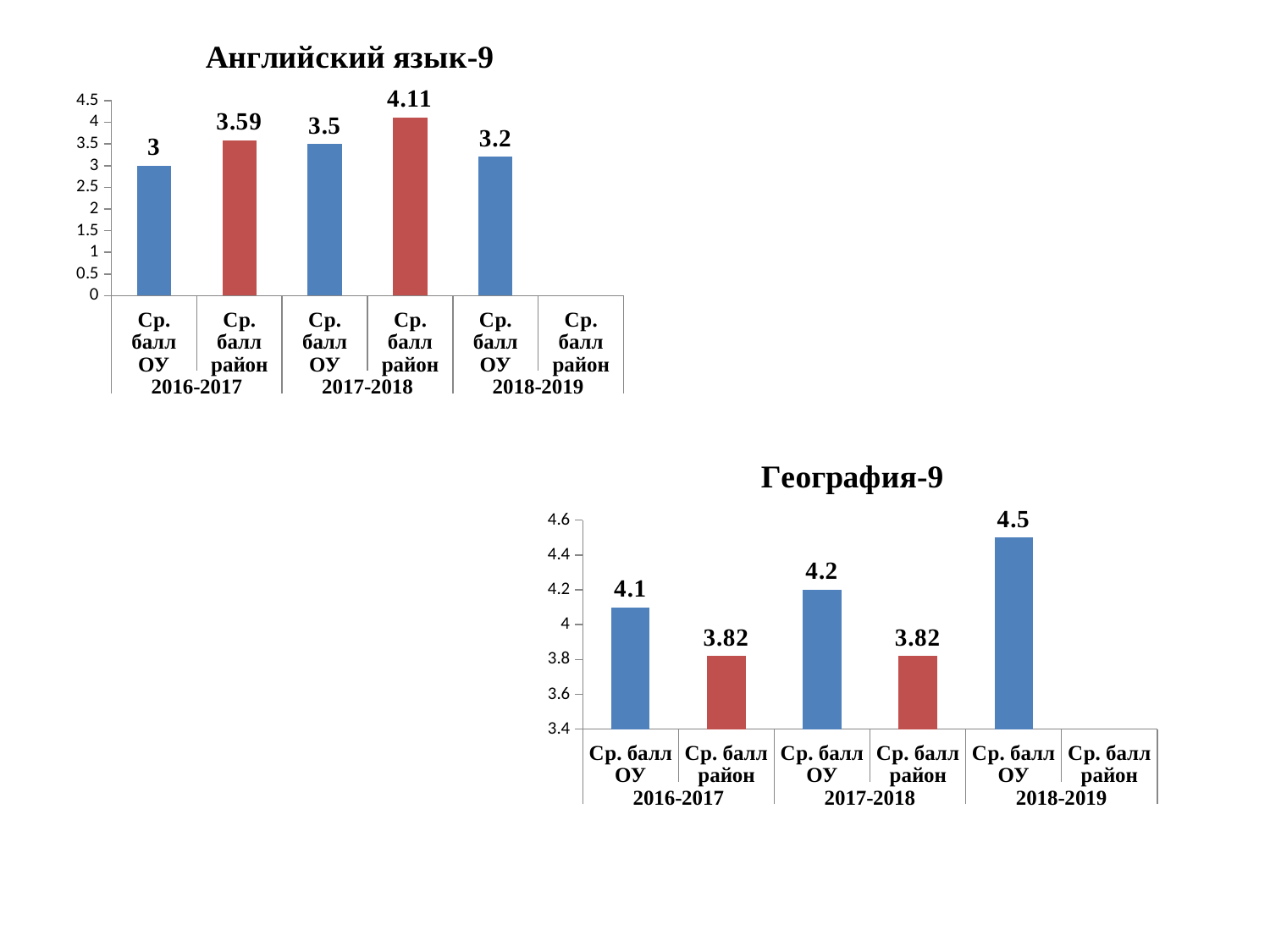
In the chart titled "Английский язык-9", which bar has the lowest value? Ср. балл ОУ, 2016-2017 In the chart titled "Английский язык-9", what is the difference between "Ср. балл район" and "Ср. балл ОУ" in 2017-2018? 0.61 In the chart titled "Английский язык-9", what is the value for "Ср. балл район" in 2017-2018? 4.11 What kind of chart is the chart titled "География-9"? bar chart In the chart titled "География-9", what is the value for "Ср. балл ОУ" in 2018-2019? 4.5 In the chart titled "Английский язык-9", what is the value for "Ср. балл ОУ" in 2016-2017? 3 In the chart titled "География-9", what is the value for "Ср. балл район" in 2016-2017? 3.82 In the chart titled "Английский язык-9", which bar has the highest value? Ср. балл район, 2017-2018 In the chart titled "География-9", which is larger in 2017-2018: "Ср. балл ОУ" or "Ср. балл район"? Ср. балл ОУ In the chart titled "География-9", do the "Ср. балл ОУ" values rise or fall from 2016-2017 to 2018-2019? rise In the chart titled "География-9", what is the difference between "Ср. балл ОУ" and "Ср. балл район" in 2016-2017? 0.28 In the chart titled "Английский язык-9", how many bars are plotted? 5